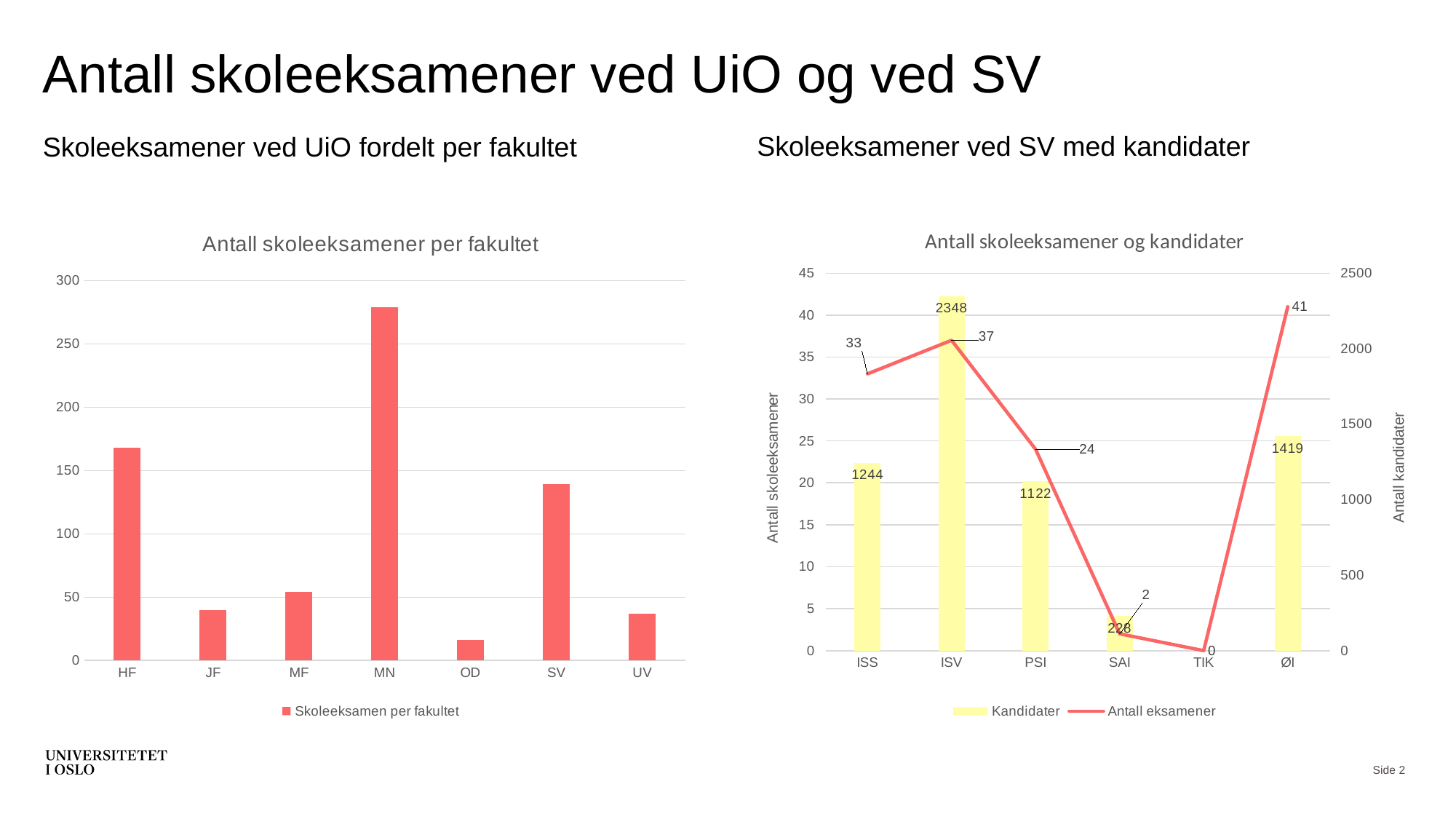
In the left chart 'Antall skoleeksamener per fakultet', which has more school exams, HF or SV? HF How many series does the legend of the right chart 'Antall skoleeksamener og kandidater' list? 2 In the left chart 'Antall skoleeksamener per fakultet', is the value for HF greater or less than 150? greater In the left chart 'Antall skoleeksamener per fakultet', which faculty has the highest number of school exams? MN In the right chart 'Antall skoleeksamener og kandidater', how many candidates (Kandidater) does ISV have? 2348 In the right chart 'Antall skoleeksamener og kandidater', what is the difference in candidates between ISS and PSI? 122 In the left chart 'Antall skoleeksamener per fakultet', how many faculties are shown on the x axis? 7 In the left chart 'Antall skoleeksamener per fakultet', is the value for SV greater or less than 150? less What type of chart is the left chart, 'Antall skoleeksamener per fakultet'? bar chart In the right chart 'Antall skoleeksamener og kandidater', which unit has the lowest number of exams (Antall eksamener)? TIK In the right chart 'Antall skoleeksamener og kandidater', what is the number of exams (Antall eksamener) for ØI? 41 In the left chart 'Antall skoleeksamener per fakultet', which faculty has the lowest number of school exams? OD